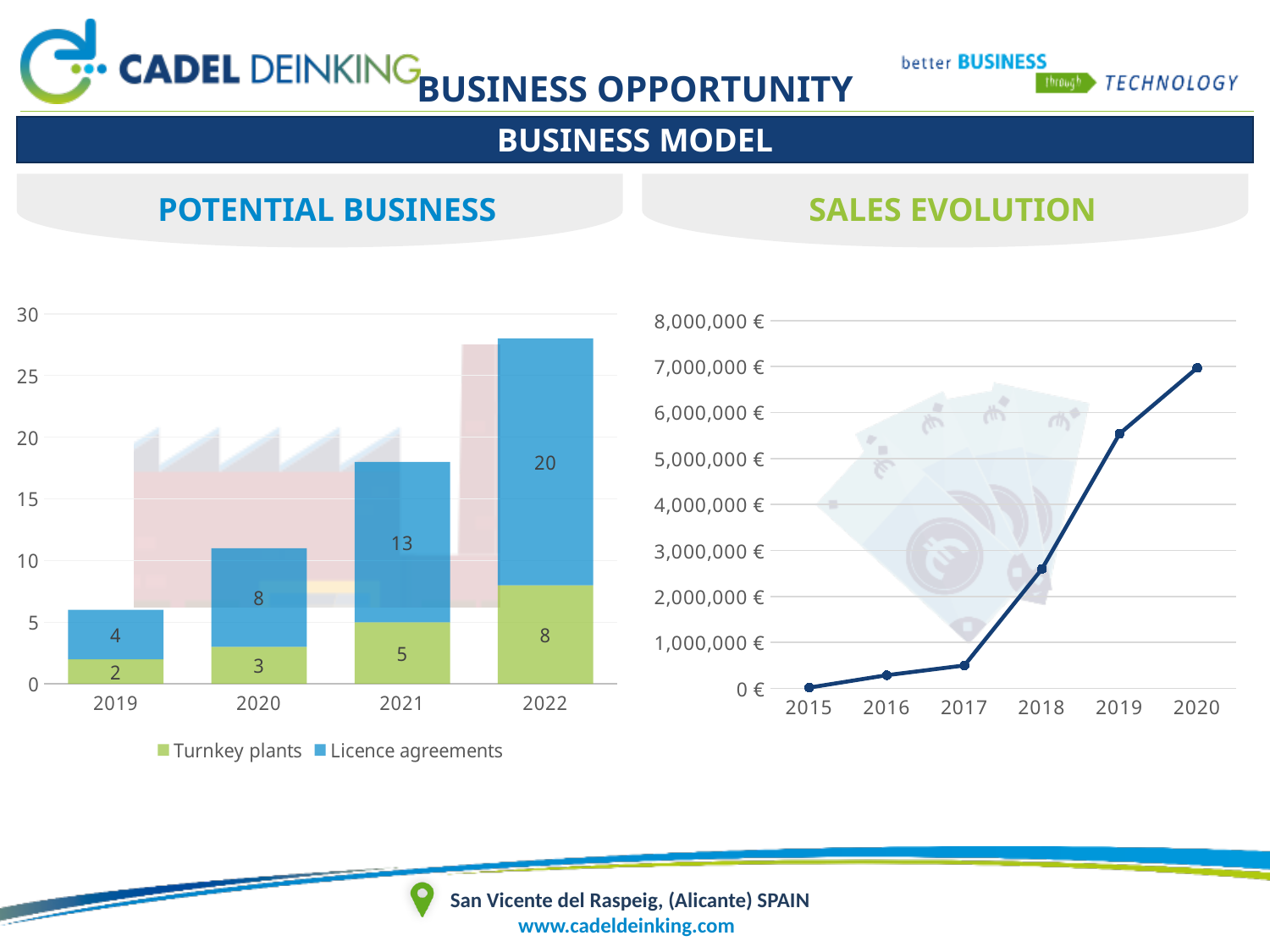
In the POTENTIAL BUSINESS chart, which year has the highest value for Licence agreements? 2022 In the POTENTIAL BUSINESS chart, what is the value for Licence agreements in 2021? 13 In the SALES EVOLUTION chart, is the value for 2019 greater or less than 5,000,000 €? greater In the POTENTIAL BUSINESS chart, what is the value for Turnkey plants in 2020? 3 What kind of chart is the SALES EVOLUTION chart? Line chart In the POTENTIAL BUSINESS chart, how many years are shown on the x axis? 4 In the SALES EVOLUTION chart, do the values rise or fall from 2015 to 2020? Rise In the POTENTIAL BUSINESS chart, what is the difference between Licence agreements and Turnkey plants in 2022? 12 In the POTENTIAL BUSINESS chart, what is the total of the stacked bar for 2019? 6 In the POTENTIAL BUSINESS chart, which year has the lowest value for Turnkey plants? 2019 In the POTENTIAL BUSINESS chart, how many series does the legend list? 2 In the POTENTIAL BUSINESS chart, what is the total of the stacked bar for 2022? 28